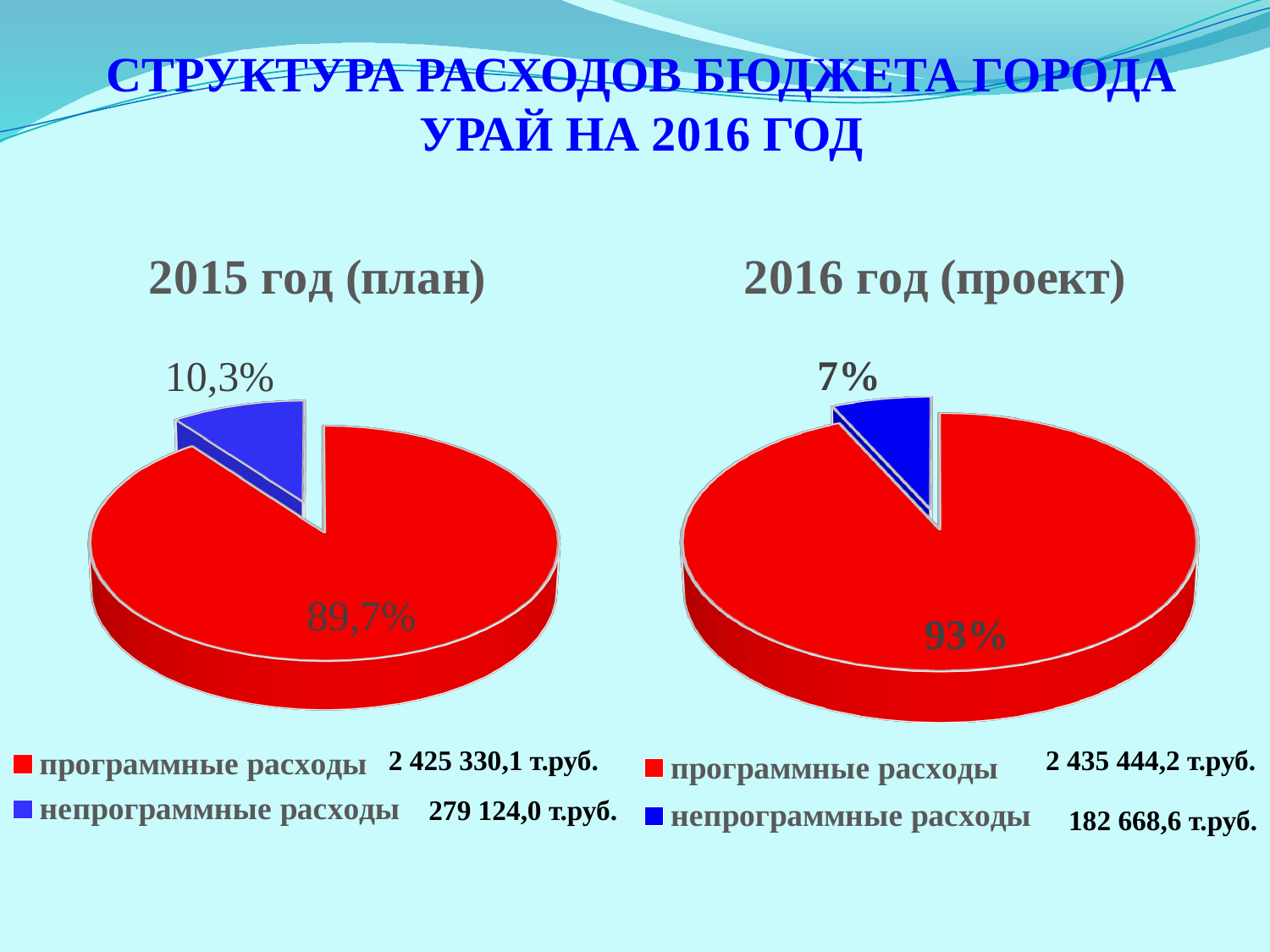
In the "2016 год (проект)" chart, what share of the pie is "программные расходы"? 93% Which is larger: the share of "непрограммные расходы" in the "2015 год (план)" chart or in the "2016 год (проект)" chart? 2015 год (план) In the "2016 год (проект)" chart, which category has the smallest slice? непрограммные расходы In the "2015 год (план)" chart, what share of the pie is "программные расходы"? 89,7% How many slices does the "2016 год (проект)" chart have? 2 What type of chart is used for "2015 год (план)"? pie chart In the "2015 год (план)" chart, which category has the largest slice? программные расходы In the "2016 год (проект)" chart, what share of the pie is "непрограммные расходы"? 7% In the "2016 год (проект)" chart, what colour is the "непрограммные расходы" slice? blue In the "2016 год (проект)" chart, what is the difference in percentage points between "программные расходы" and "непрограммные расходы"? 86% In the "2015 год (план)" chart, what is the difference in percentage points between "программные расходы" and "непрограммные расходы"? 79,4%